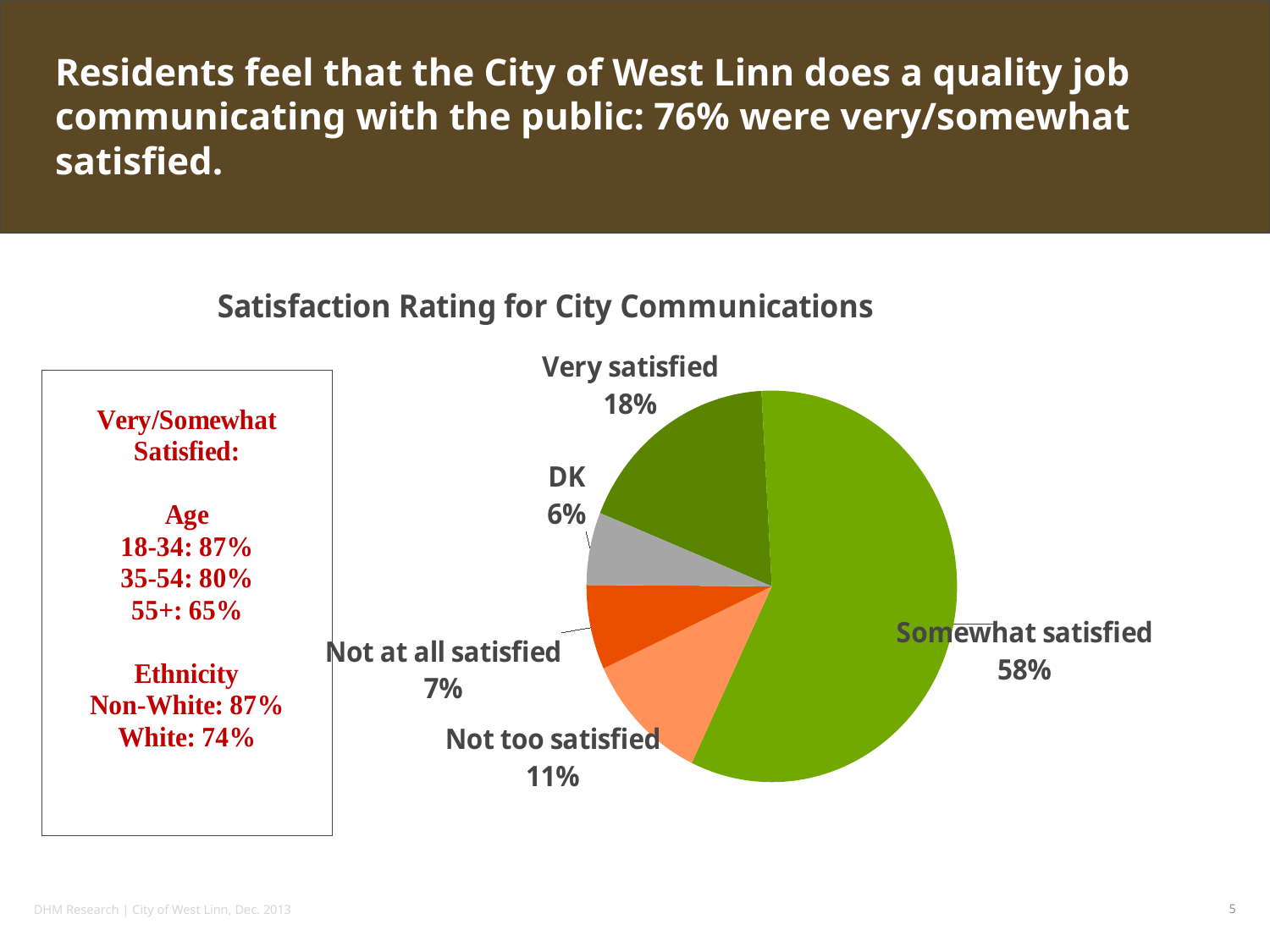
What is the difference between the somewhat satisfied and very satisfied shares? 40% What percentage of residents were not too satisfied? 11% What percentage of residents were very satisfied? 18% Which category has the smallest share of the pie? DK Which category has the largest share of the pie? Somewhat satisfied What is the combined share of very satisfied and somewhat satisfied? 76% What percentage of residents were somewhat satisfied? 58% How many categories are shown in the pie chart? 5 What percentage of residents answered DK? 6% Which is larger: the share for not too satisfied or the share for not at all satisfied? Not too satisfied What is the title of the chart? Satisfaction Rating for City Communications What type of chart is shown on the slide? Pie chart